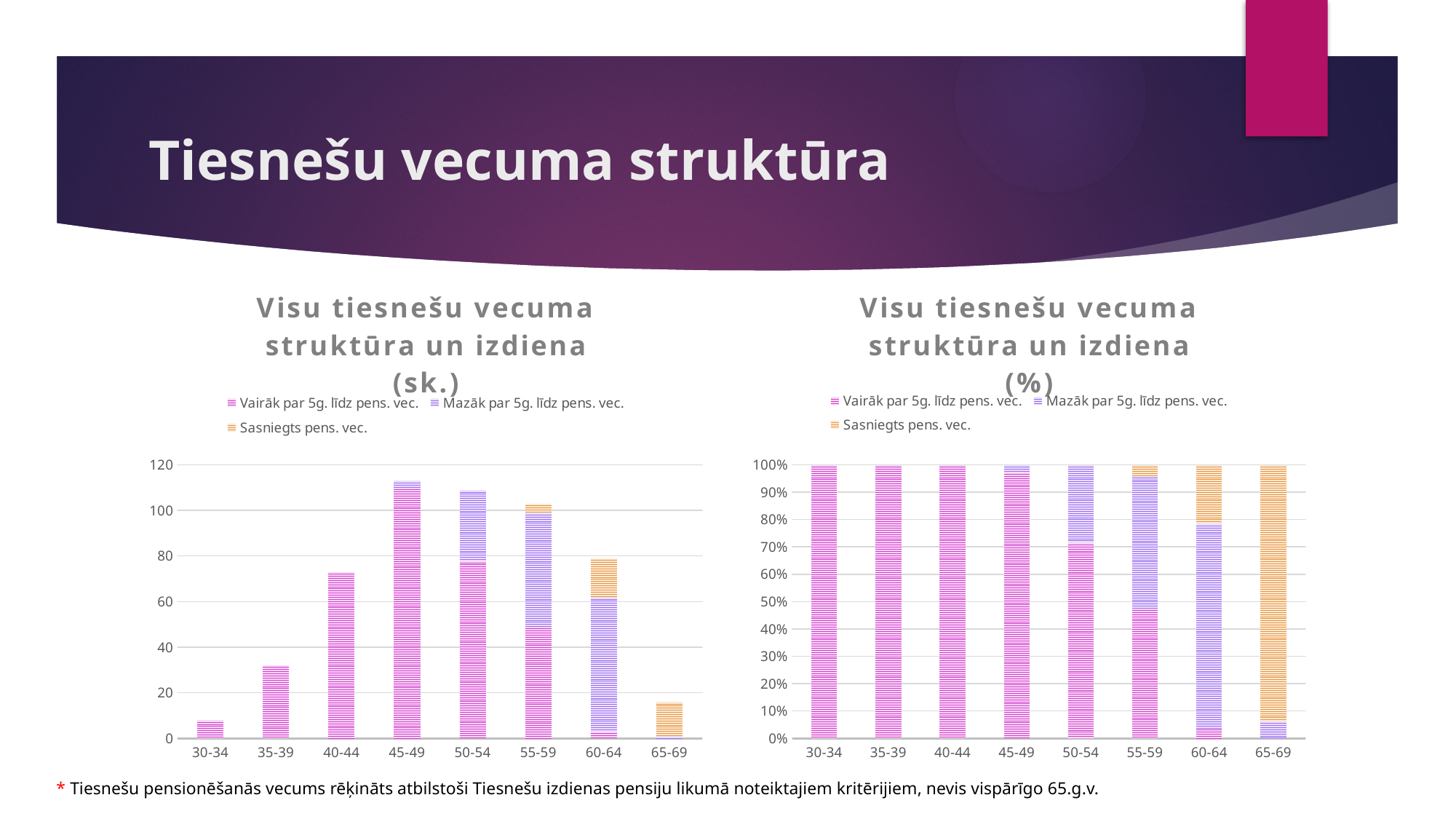
In the left chart (sk.), is the total bar for 65-69 greater or less than 20? less How many series does the legend of the right chart, "Visu tiesnešu vecuma struktūra un izdiena (%)", list? 3 In the right chart (%), is the share of "Vairāk par 5g. līdz pens. vec." for 60-64 greater or less than 10%? less In the right chart (%), is the share of "Sasniegts pens. vec." for 65-69 greater or less than 90%? greater What kind of chart is the left chart, "Visu tiesnešu vecuma struktūra un izdiena (sk.)"? bar chart In the left chart (sk.), which total bar is larger: 40-44 or 60-64? 60-64 What is the title of the right chart? Visu tiesnešu vecuma struktūra un izdiena (%) How many age-group categories are shown on the x axis of the left chart? 8 In the left chart (sk.), which age group has the lowest total bar? 30-34